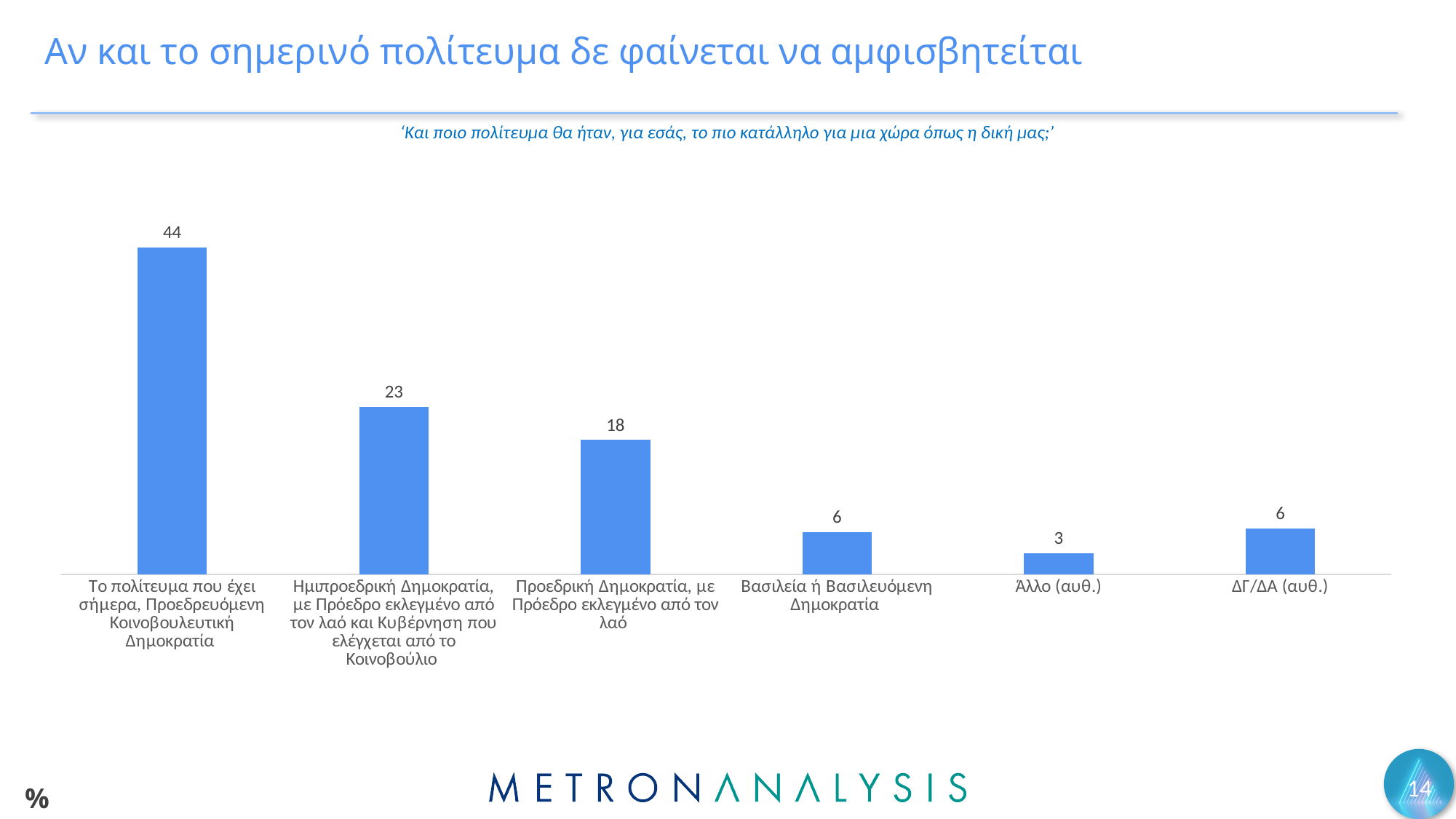
What value is shown for 'Προεδρική Δημοκρατία, με Πρόεδρο εκλεγμένο από τον λαό'? 18 What kind of chart is shown on the slide? Bar chart Which category has the lowest value? Άλλο (αυθ.) How many categories are shown on the x axis? 6 What value is shown for 'Βασιλεία ή Βασιλευόμενη Δημοκρατία'? 6 Which is larger, the value for 'Βασιλεία ή Βασιλευόμενη Δημοκρατία' or the value for 'Άλλο (αυθ.)'? Βασιλεία ή Βασιλευόμενη Δημοκρατία What is the survey question quoted above the chart? Και ποιο πολίτευμα θα ήταν, για εσάς, το πιο κατάλληλο για μια χώρα όπως η δική μας; What is the difference between the value for 'Το πολίτευμα που έχει σήμερα, Προεδρευόμενη Κοινοβουλευτική Δημοκρατία' and the value for 'Ημιπροεδρική Δημοκρατία, με Πρόεδρο εκλεγμένο από τον λαό και Κυβέρνηση που ελέγχεται από το Κοινοβούλιο'? 21 What value is shown for 'ΔΓ/ΔΑ (αυθ.)'? 6 What is the difference between the value for 'Ημιπροεδρική Δημοκρατία, με Πρόεδρο εκλεγμένο από τον λαό και Κυβέρνηση που ελέγχεται από το Κοινοβούλιο' and the value for 'Προεδρική Δημοκρατία, με Πρόεδρο εκλεγμένο από τον λαό'? 5 Which category has the highest value? Το πολίτευμα που έχει σήμερα, Προεδρευόμενη Κοινοβουλευτική Δημοκρατία What value is shown for 'Άλλο (αυθ.)'? 3